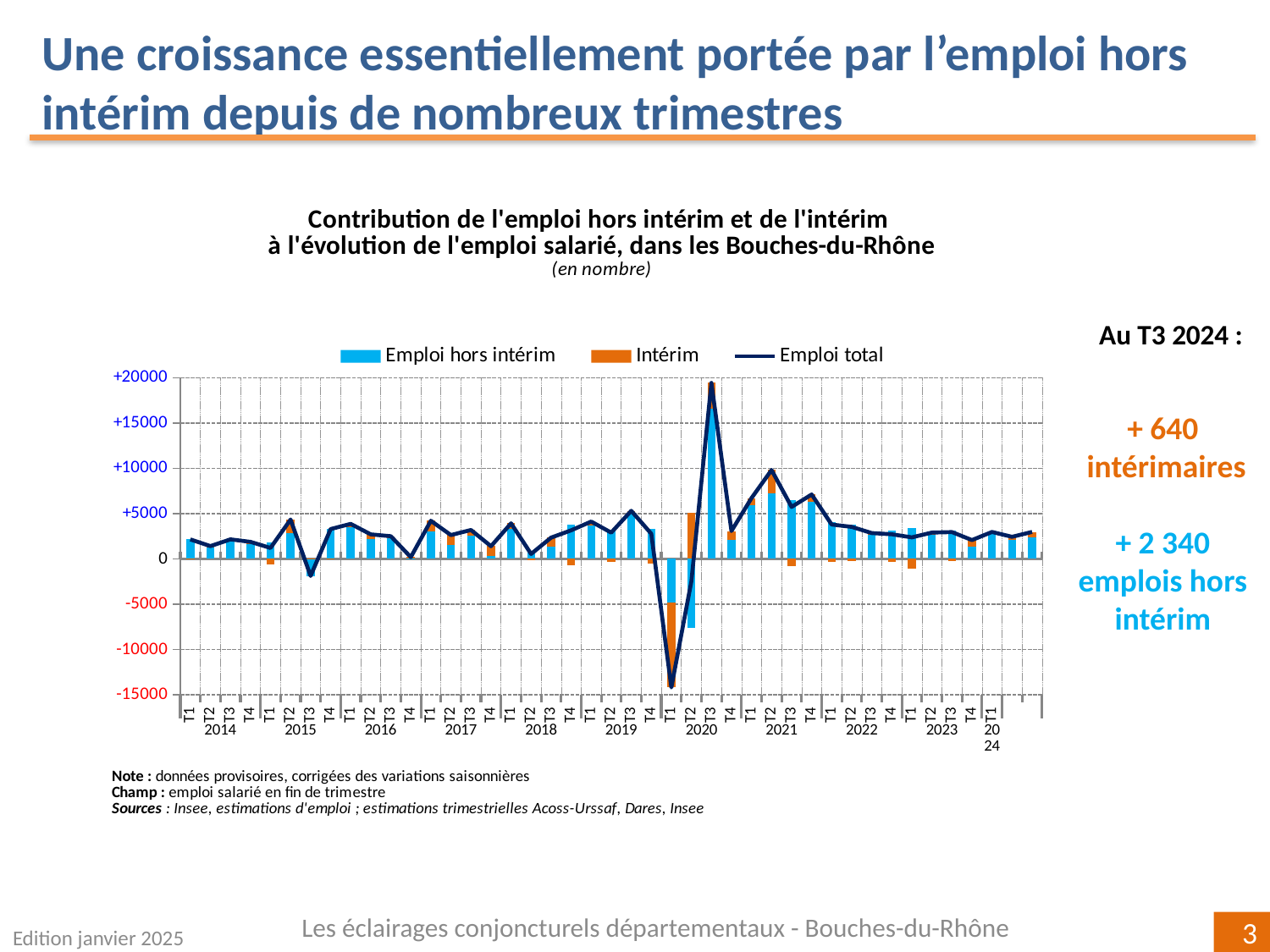
According to the annotation on the slide, what is the contribution of emploi hors intérim at T3 2024? + 2 340 emplois hors intérim Is the Emploi total value at T1 2020 greater or less than -10000? less Is the Emploi hors intérim value at T2 2021 greater or less than +5000? greater Which colour represents the Intérim series in the chart? Orange According to the annotation on the slide, what is the contribution of intérim (temporary employment) at T3 2024? + 640 intérimaires In which quarter does the Emploi total line reach its lowest value? T1 2020 At T3 2024, which contribution is larger: intérim or emploi hors intérim? Emploi hors intérim Is the Emploi total value at T3 2020 greater or less than +15000? greater In which quarter does the Emploi total line reach its highest value? T3 2020 What kind of chart is shown on the slide? A combined bar and line chart How many series does the chart legend list? 3